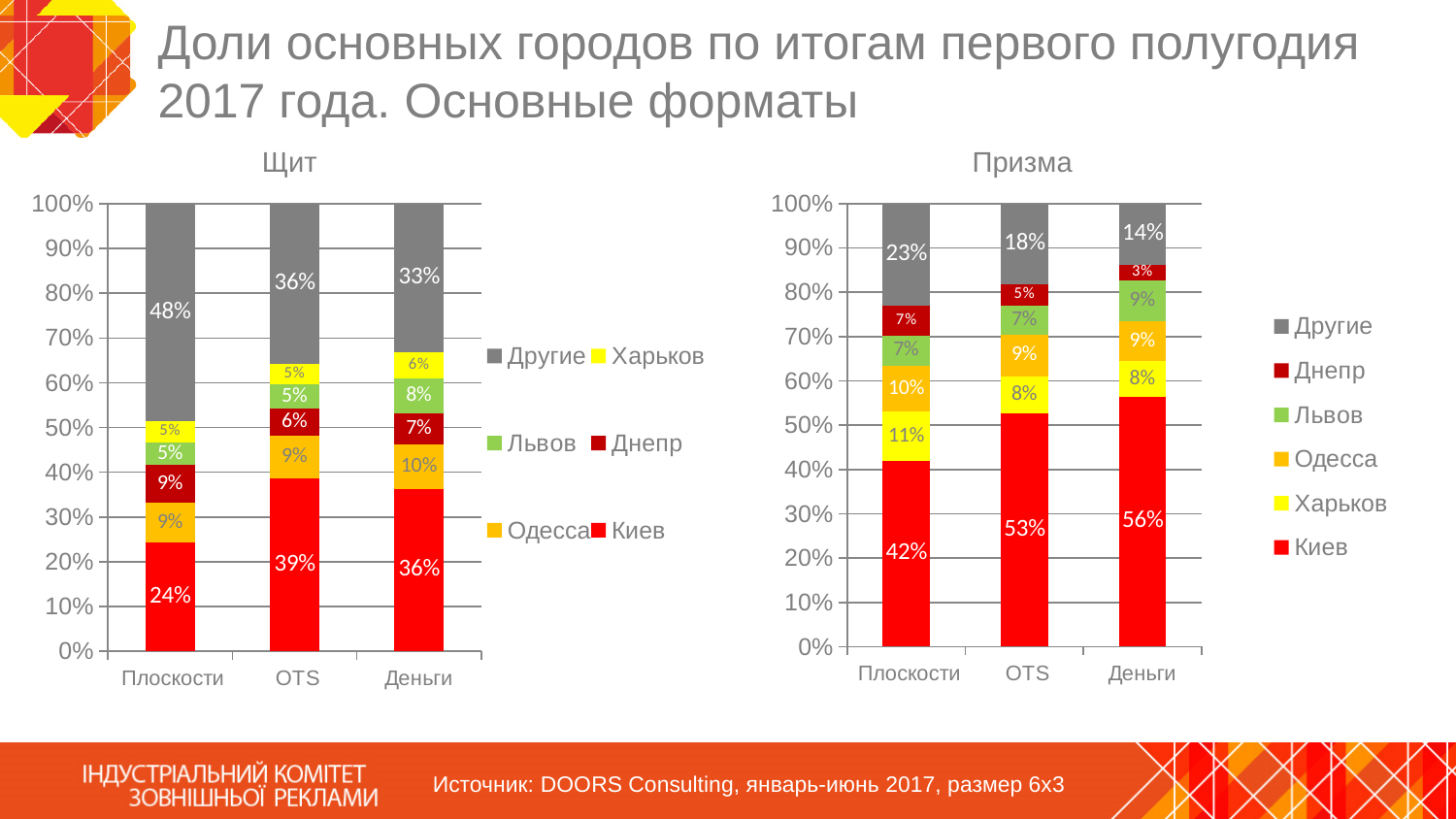
In the chart titled "Щит", what is the value for Киев in the Плоскости bar? 24% In the chart titled "Щит", which category has the lowest value for Киев? Плоскости How many series does the legend of the chart titled "Призма" list? 6 In the chart titled "Щит", what is the value for Другие in the OTS bar? 36% In the chart titled "Призма", what is the value for Другие in the Деньги bar? 14% In the chart titled "Призма", do the Другие values rise or fall from Плоскости to Деньги? Fall In the chart titled "Призма", which is larger: the Киев value for OTS or the Киев value for Плоскости? OTS What kind of chart is the chart titled "Щит"? Stacked bar chart In the chart titled "Призма", what is the value for Харьков in the Плоскости bar? 11% In the chart titled "Призма", which category has the highest value for Киев? Деньги In the chart titled "Щит", what is the difference between the Другие values for Плоскости and Деньги? 15% How many categories are shown on the x axis of the chart titled "Призма"? 3